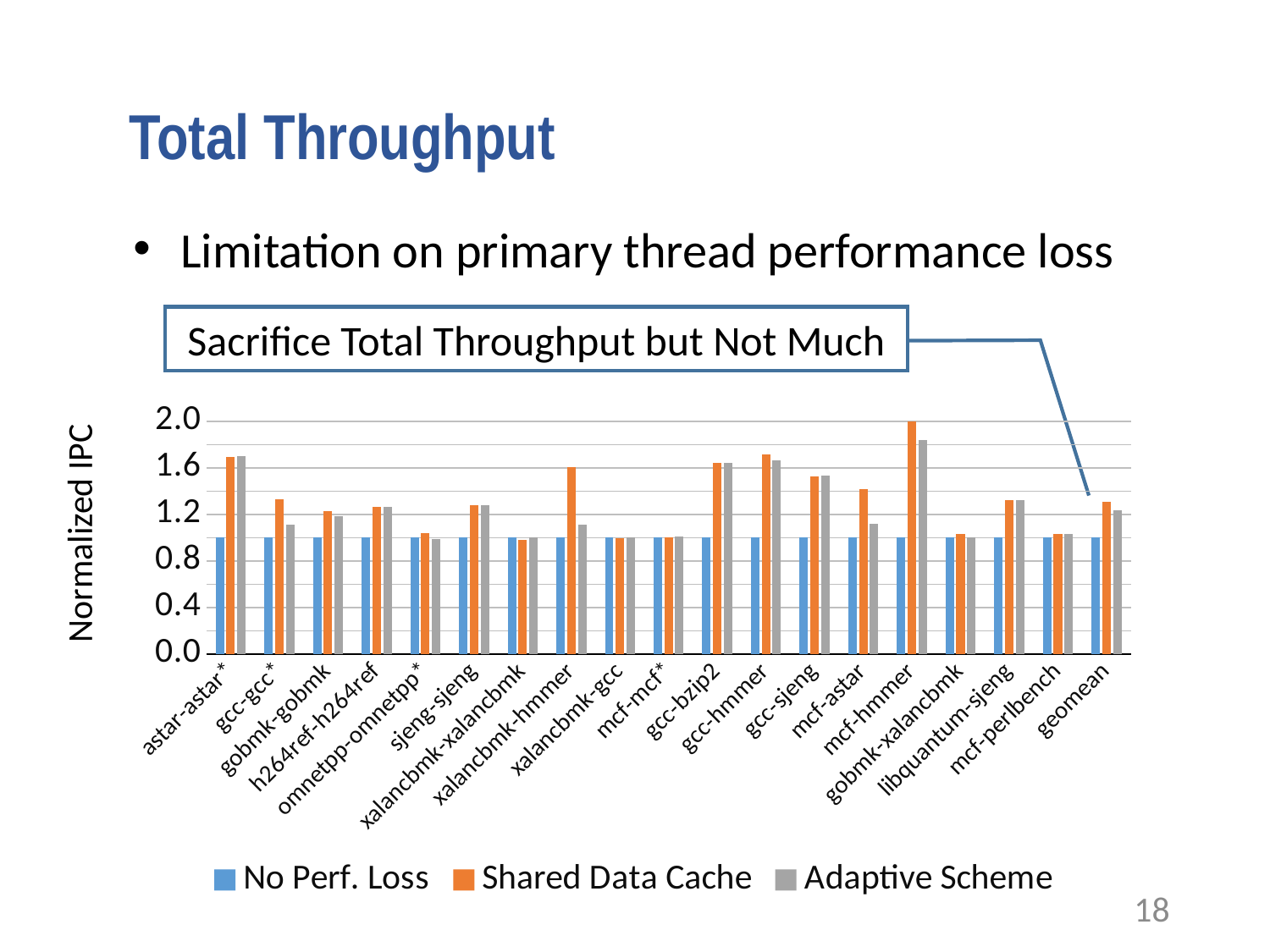
For mcf-astar, which is larger: the Shared Data Cache value or the Adaptive Scheme value? Shared Data Cache For xalancbmk-hmmer, which is larger: the Shared Data Cache value or the Adaptive Scheme value? Shared Data Cache How many categories are shown along the x axis of the chart? 19 What kind of chart is shown on the slide? bar chart Which series are listed in the chart legend? No Perf. Loss, Shared Data Cache, Adaptive Scheme How many series does the chart legend list? 3 Is the Shared Data Cache value for gcc-hmmer greater or less than 1.6? greater What is the label of the y axis of the chart? Normalized IPC Is the Adaptive Scheme value for gcc-gcc* greater or less than 1.2? less For which category is the Shared Data Cache value highest? mcf-hmmer Is the Adaptive Scheme value for mcf-hmmer greater or less than 1.6? greater